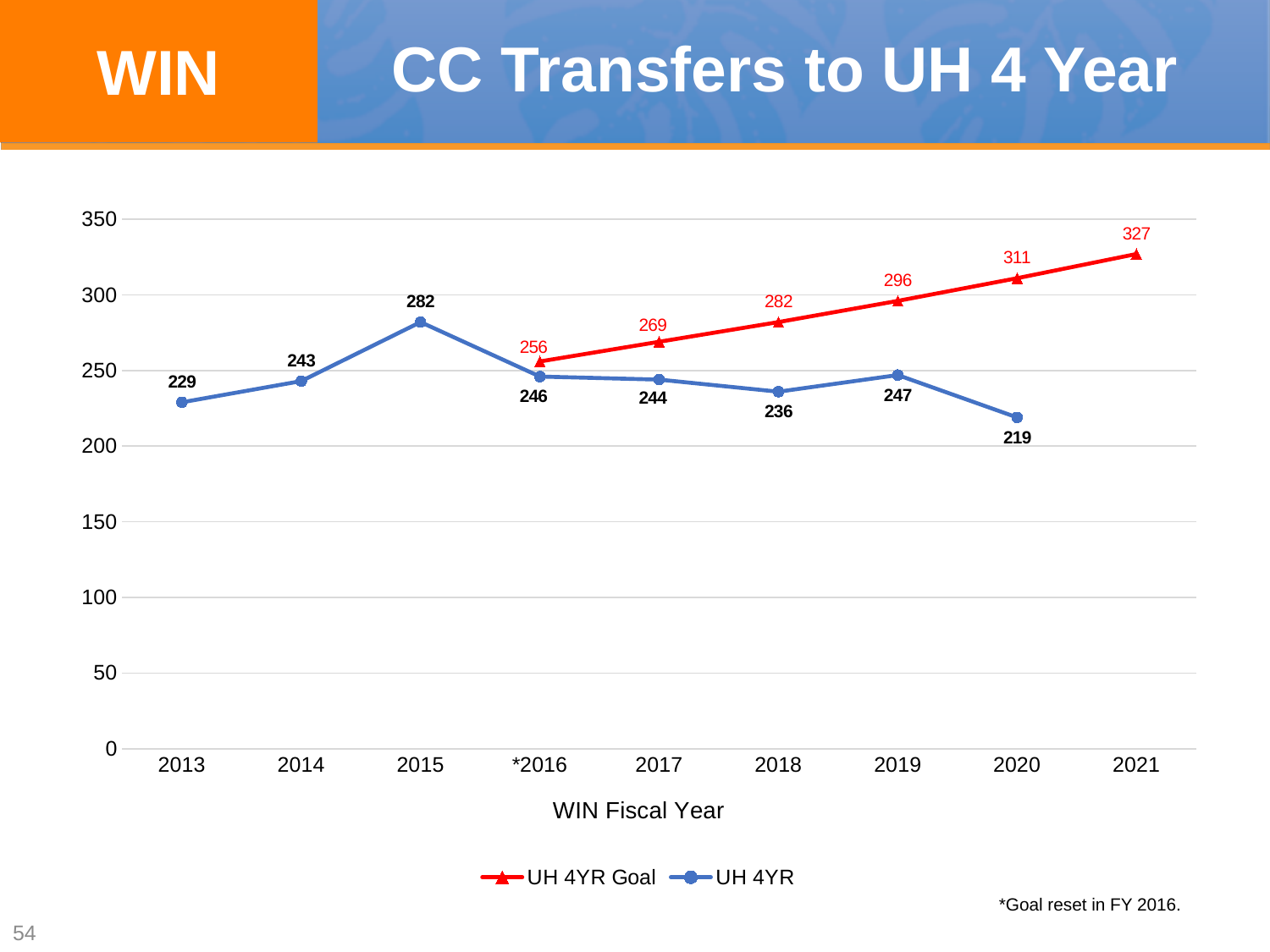
What is the UH 4YR value for 2020? 219 In which year is the UH 4YR series highest? 2015 How many series does the legend list? 2 What type of chart is shown on the slide? Line chart What is the label of the x axis? WIN Fiscal Year Does the UH 4YR Goal series rise or fall from 2016 to 2021? Rise How many years are shown on the x axis? 9 What is the difference between the UH 4YR Goal and the UH 4YR value in 2020? 92 Which is larger in 2018, the UH 4YR Goal or the UH 4YR value? UH 4YR Goal In which year is the UH 4YR series lowest? 2020 What is the UH 4YR Goal value for 2021? 327 What is the UH 4YR value for 2015? 282